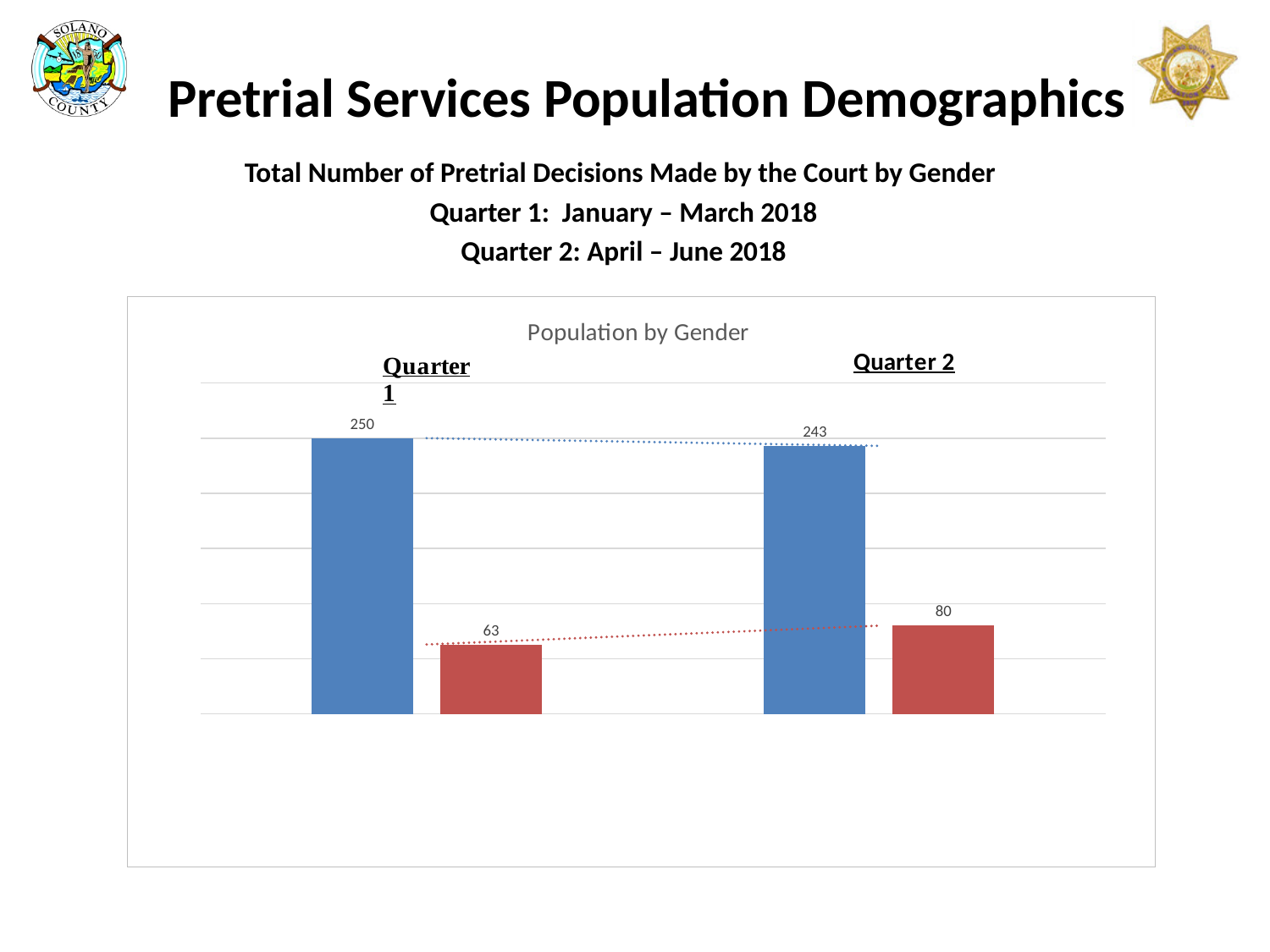
What is the difference between the red bar values for Quarter 2 and Quarter 1? 17 What is the value of the red bar for Quarter 1 in the Population by Gender chart? 63 Which bar has the lowest value in the Population by Gender chart? Quarter 1 red bar (63) What is the value of the red bar for Quarter 2 in the Population by Gender chart? 80 What kind of chart is shown on the slide? Bar chart What is the title of the chart on the slide? Population by Gender What is the value of the blue bar for Quarter 2 in the Population by Gender chart? 243 How many bars are plotted in the Population by Gender chart? 4 What is the value of the blue bar for Quarter 1 in the Population by Gender chart? 250 Which bar has the highest value in the Population by Gender chart? Quarter 1 blue bar (250) Is the red bar larger in Quarter 1 or Quarter 2? Quarter 2 What is the difference between the blue bar values for Quarter 1 and Quarter 2? 7